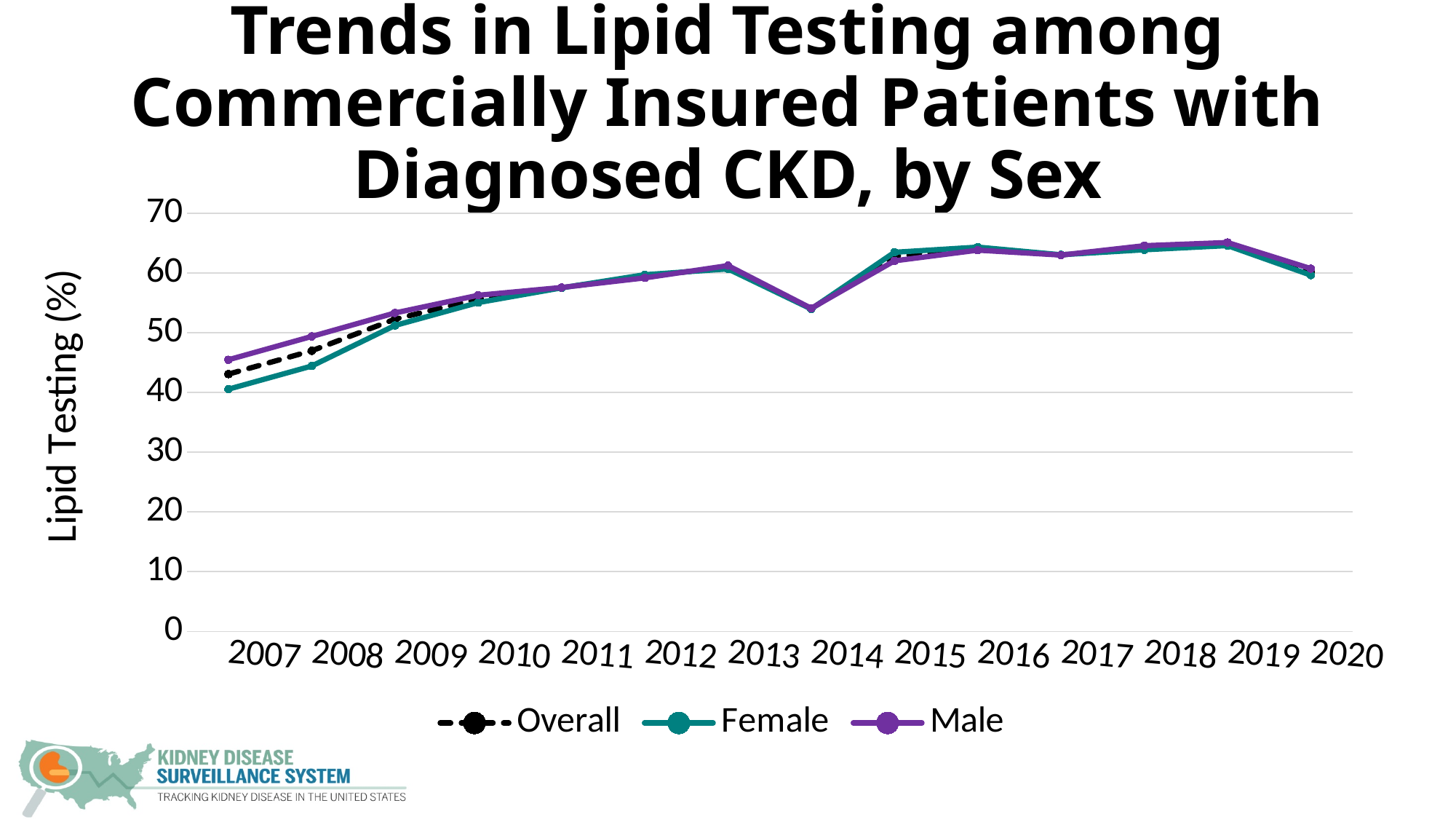
What kind of chart is shown on the slide? Line chart Is the value for Male in 2007 greater or less than 40? greater Is the value for Overall in 2014 greater or less than 50? greater How many years are plotted along the x axis? 14 Is the value for Male in 2019 greater or less than 60? greater In which year is the Female value lowest? 2007 How many series does the legend list? 3 In 2007, which is larger, the Male value or the Female value? Male Do the Overall values generally rise or fall from 2007 to 2012? Rise What is the label on the y axis? Lipid Testing (%)